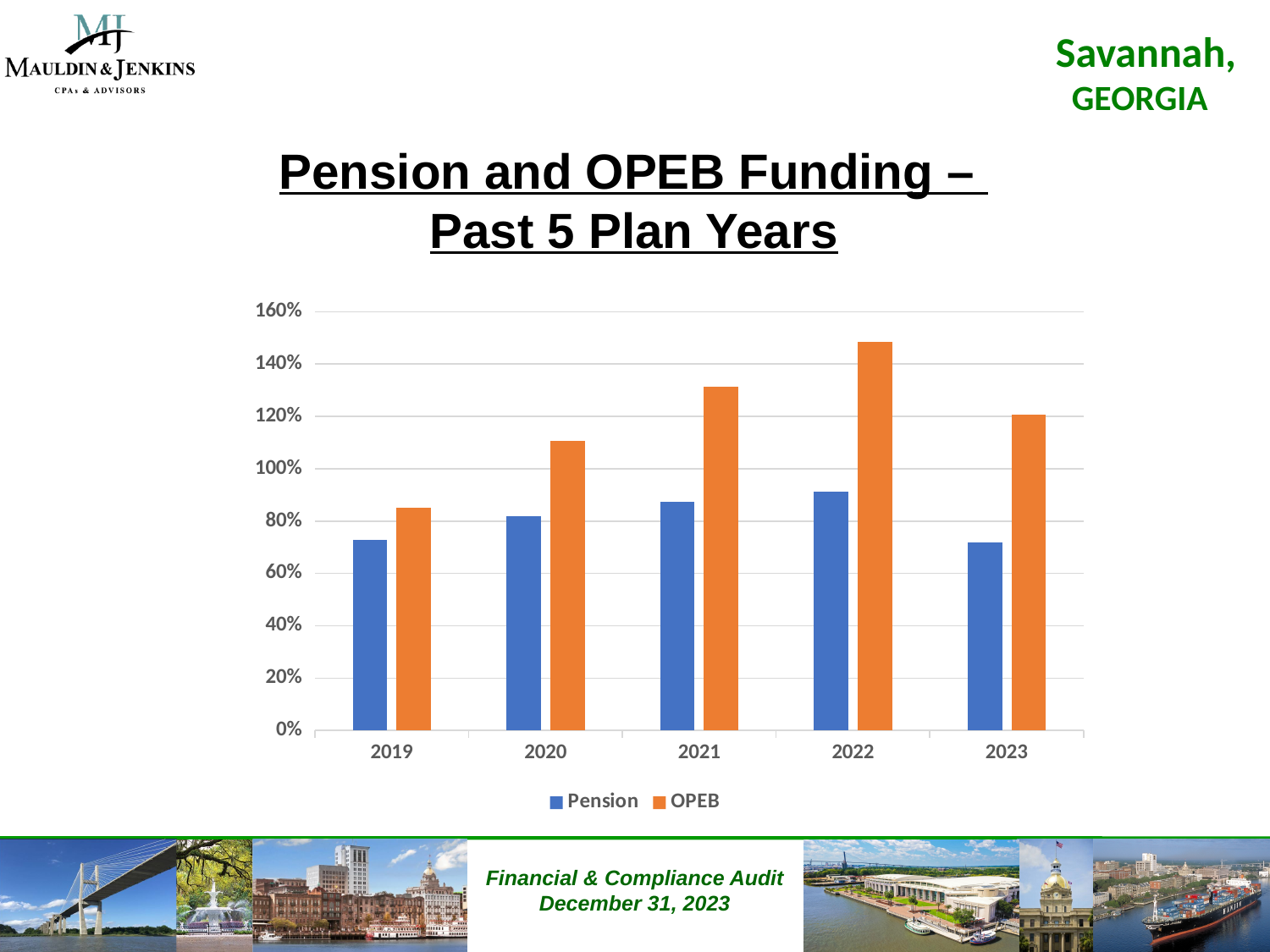
In 2021, which is larger, the Pension value or the OPEB value? OPEB Is the OPEB value for 2019 greater or less than 100%? less Do the OPEB values rise or fall from 2019 to 2022? rise What kind of chart is shown on the slide? bar chart Which year has the lowest OPEB funding value? 2019 How many series does the legend list? 2 Is the OPEB value for 2023 greater or less than 100%? greater Is the Pension value for 2019 greater or less than 80%? less Which year has the highest Pension funding value? 2022 How many years are shown on the x axis? 5 Which year has the highest OPEB funding value? 2022